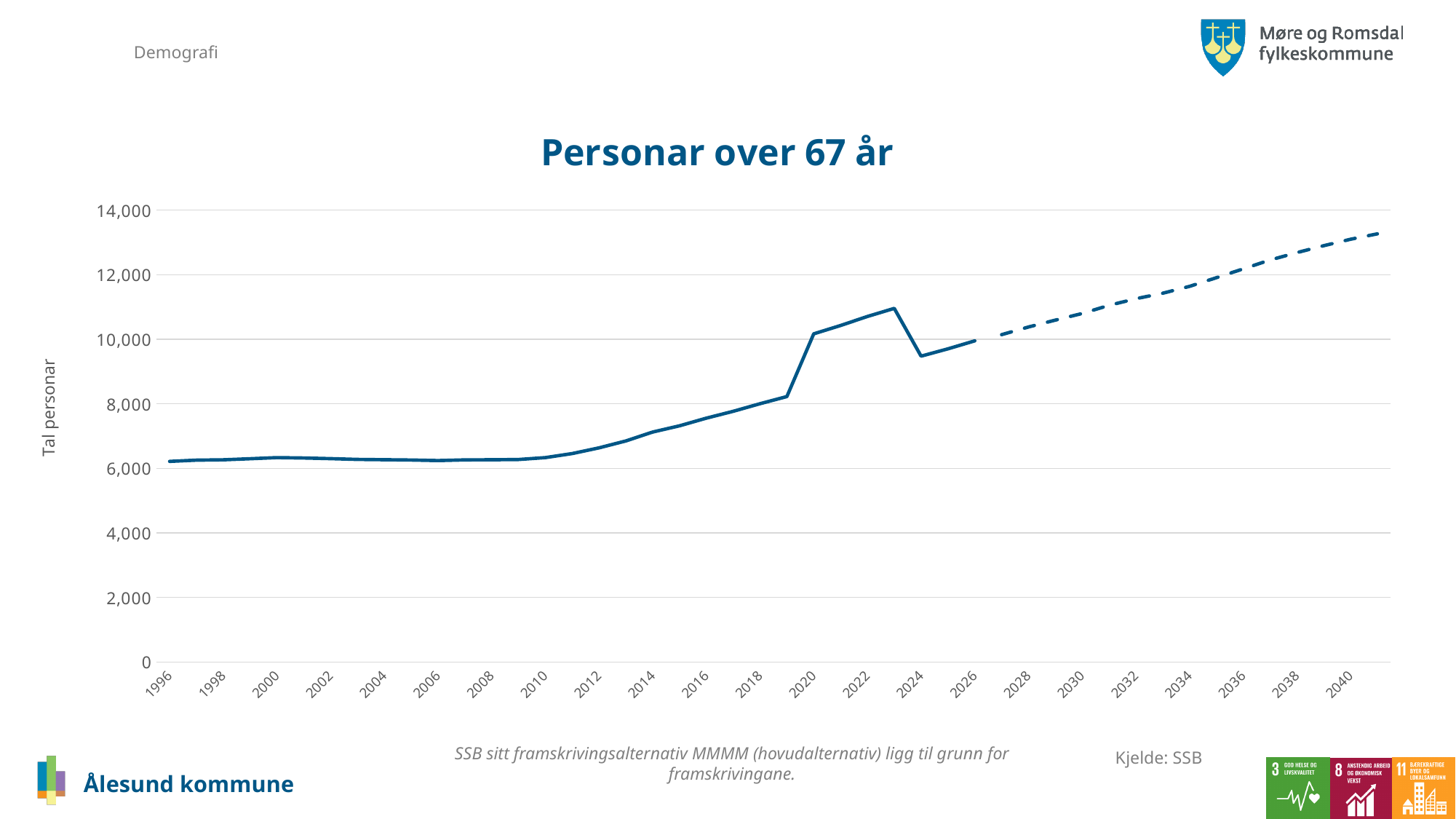
Which is larger, the value for 2024 or the value for 2022? 2022 Is the value for 2040 greater or less than 14,000? less Is the value for 2022 greater or less than 12,000? less Is the value for 2024 greater or less than 10,000? less What is the title of the chart? Personar over 67 år Does the number of persons over 67 generally rise or fall from 1996 to 2040? Rise What kind of chart is shown on the slide? Line chart What is the label on the vertical axis of the chart? Tal personar